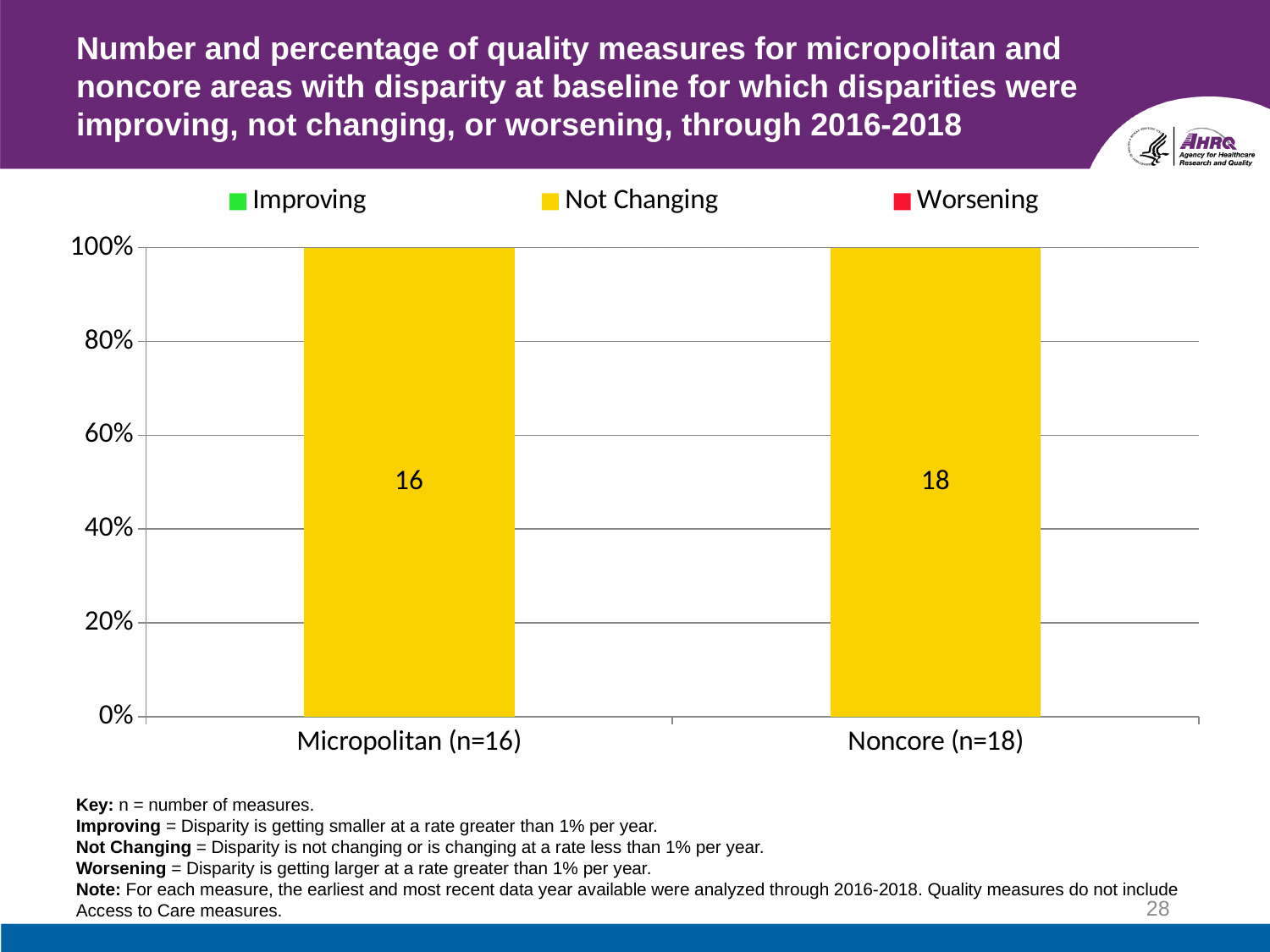
Is the Not Changing bar for Micropolitan (n=16) greater or less than 80%? greater Which category has the lowest number of Not Changing measures? Micropolitan (n=16) How many categories are shown on the x axis of the chart? 2 Which category has the highest number of Not Changing measures? Noncore (n=18) Which area has more Not Changing measures, Micropolitan or Noncore? Noncore How many quality measures for Micropolitan areas are in the Not Changing category? 16 What colour represents the Not Changing series in the legend? Yellow What are the three series listed in the chart legend? Improving, Not Changing, Worsening What is the difference between the number of Not Changing measures for Noncore and Micropolitan areas? 2 How many quality measures for Noncore areas are in the Not Changing category? 18 How many series does the chart legend list? 3 What kind of chart is shown on the slide? Stacked bar chart